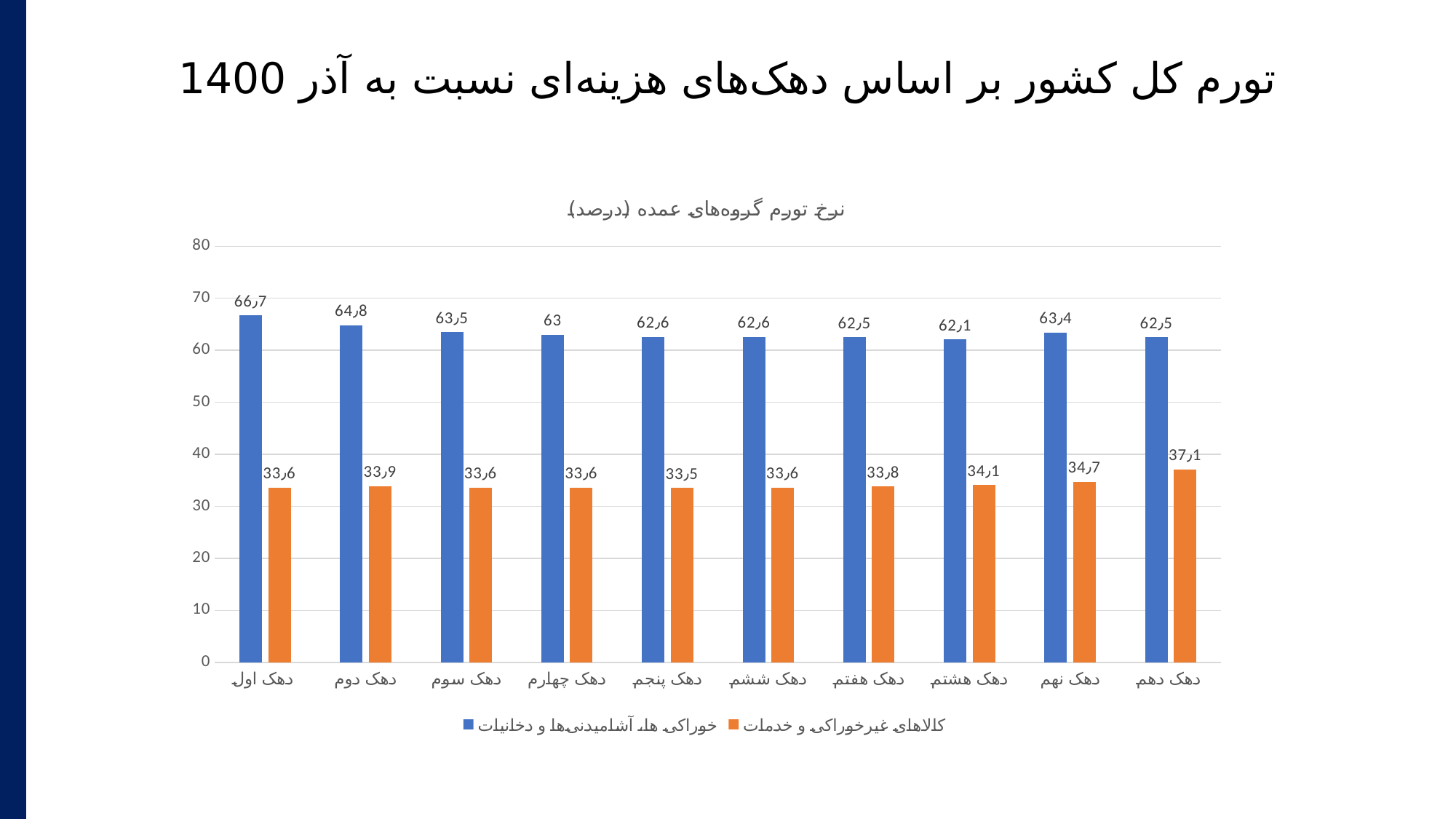
What type of chart is shown on the slide? bar chart What is the value of the blue series for دهک نهم? 63٫4 What is the difference between the blue series values for دهک اول and دهک دوم? 1٫9 How many categories (deciles) are shown on the x axis? 10 Which decile has the highest value in the orange series (کالاهای غیرخوراکی و خدمات)? دهک دهم For دهک پنجم, which series has the larger value: the blue series or the orange series? the blue series (خوراکی‌ها، آشامیدنی‌ها و دخانیات) What is the value of the blue series (خوراکی‌ها، آشامیدنی‌ها و دخانیات) for دهک اول? 66٫7 What is the title of the chart? نرخ تورم گروه‌های عمده (درصد) What is the value of the orange series (کالاهای غیرخوراکی و خدمات) for دهک دهم? 37٫1 How many series does the legend list? 2 Which decile has the highest value in the blue series (خوراکی‌ها، آشامیدنی‌ها و دخانیات)? دهک اول Which decile has the lowest value in the blue series? دهک هشتم